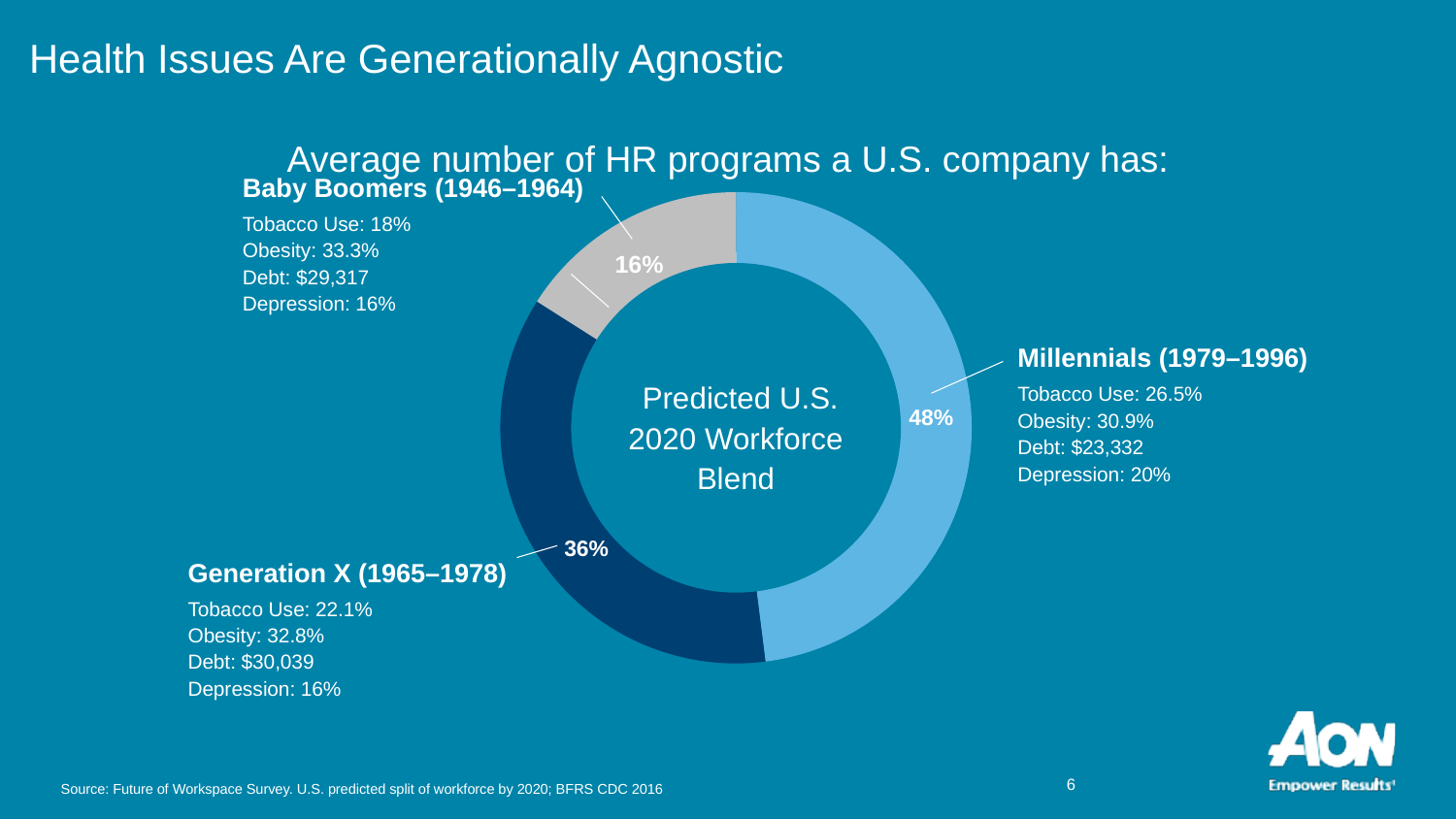
What type of chart is used to show the predicted U.S. 2020 workforce blend? Donut (pie) chart What is the difference in percentage points between the Millennials share and the Generation X share of the workforce blend? 12 percentage points Which generation has the largest share of the predicted U.S. 2020 workforce blend? Millennials (1979–1996) What share of the predicted U.S. 2020 workforce blend is Baby Boomers (1946–1964)? 16% What colour is the Baby Boomers slice of the donut chart? Grey What share of the predicted U.S. 2020 workforce blend is Millennials (1979–1996)? 48% What is the difference in percentage points between the Generation X share and the Baby Boomers share of the workforce blend? 20 percentage points Which has a larger share of the predicted 2020 workforce blend, Generation X or Baby Boomers? Generation X What text appears in the center of the donut chart? Predicted U.S. 2020 Workforce Blend What share of the predicted U.S. 2020 workforce blend is Generation X (1965–1978)? 36% How many generations are shown as slices in the workforce blend chart? 3 Which generation has the smallest share of the predicted U.S. 2020 workforce blend? Baby Boomers (1946–1964)